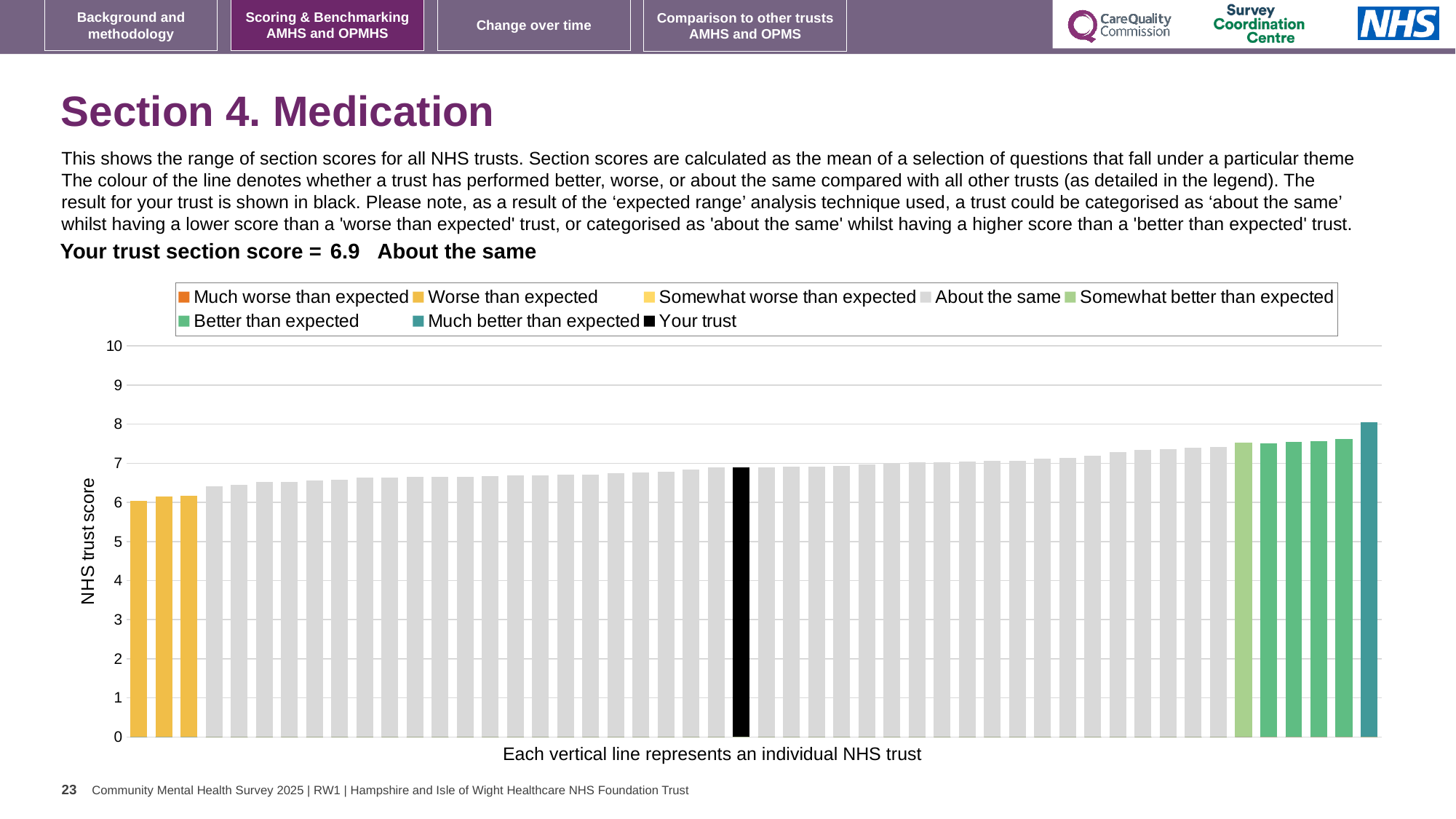
Is the value of the lowest bar greater or less than 7? less What is the section score for your trust shown on the slide? 6.9 How many bars are coloured as 'Worse than expected'? 3 Is the value of the lowest bar greater or less than 5? greater Is the value for your trust greater or less than 6? greater Which category is your trust's section score placed in? About the same Do the bar values rise or fall from left to right along the x axis? rise What is the label on the vertical axis of the chart? NHS trust score How many bars are coloured as 'Much better than expected'? 1 What kind of chart is shown on the slide? bar chart Which legend category does the tallest bar belong to? Much better than expected How many entries does the chart legend list? 8